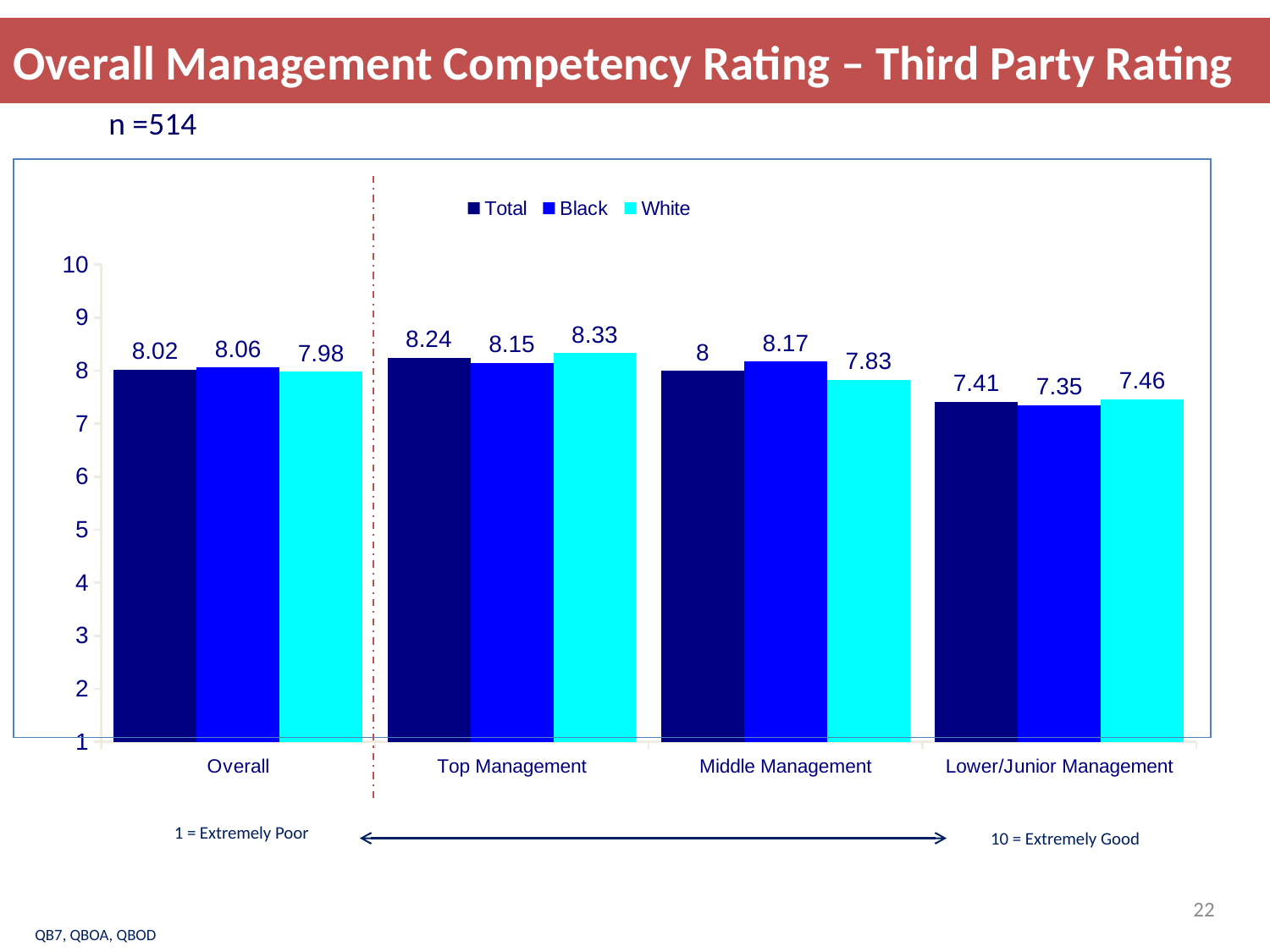
How many series does the legend list? 3 What is the Total rating for Overall? 8.02 What is the difference between the White and Black ratings for Top Management? 0.18 What is the Black rating for Lower/Junior Management? 7.35 Which category has the highest White rating? Top Management How many management categories are shown on the x axis? 4 Which is larger for Middle Management, the Black rating or the White rating? Black What is the White rating for Middle Management? 7.83 Which category has the lowest Total rating? Lower/Junior Management What is the Total rating for Top Management? 8.24 What is the sample size (n) shown on the slide? 514 What kind of chart is shown on the slide? Bar chart